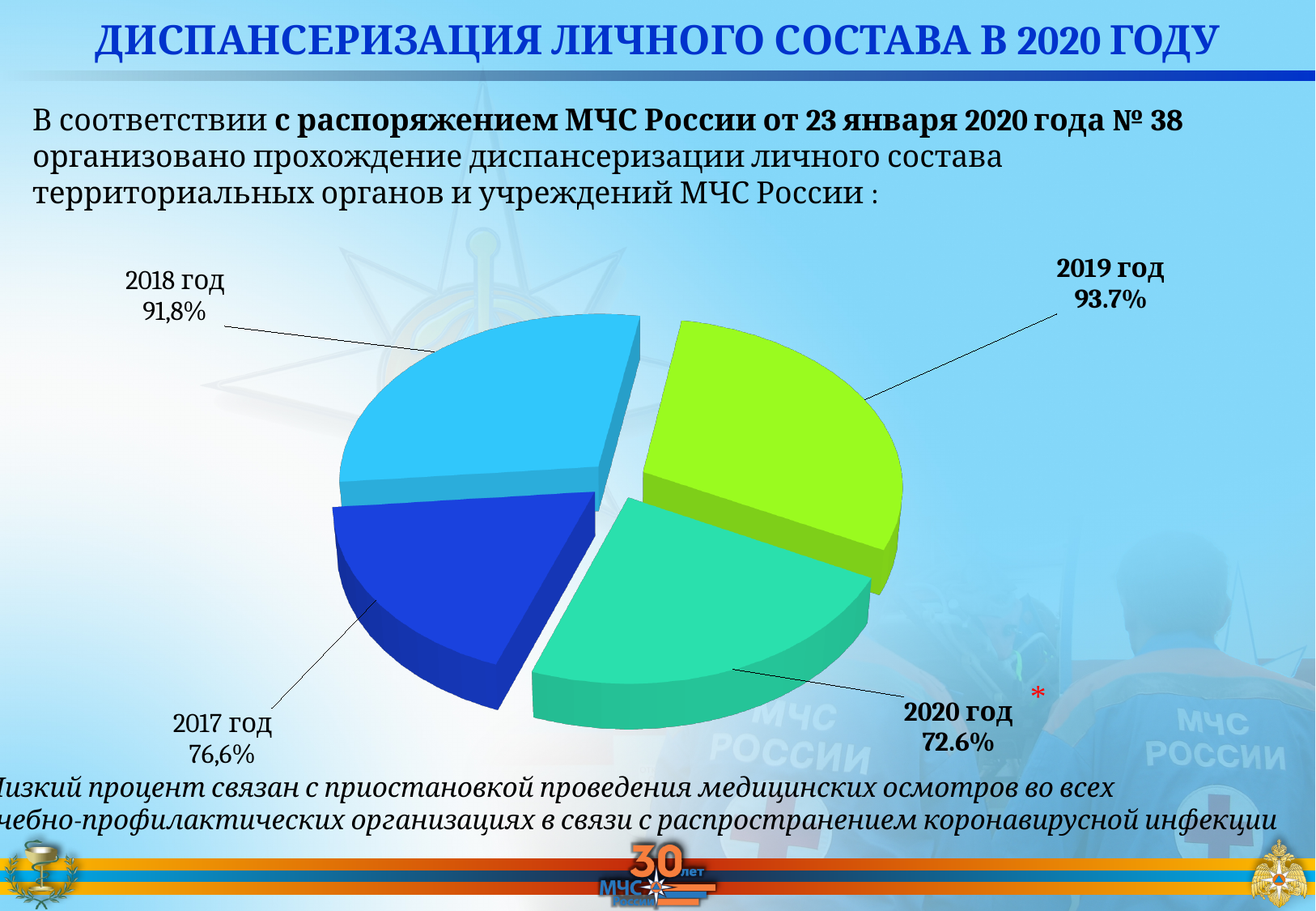
Which year is represented by the dark blue slice? 2017 год What is the difference between the values for 2019 год and 2020 год? 21.1% What is the value shown for 2018 год? 91,8% Which is larger, the value for 2018 год or for 2019 год? 2019 год What is the value shown for 2017 год? 76,6% What kind of chart is shown on the slide? pie chart How many slices does the pie chart have? 4 What is the value shown for 2019 год? 93.7% What is the value shown for 2020 год? 72.6% Did the value rise or fall from 2019 год to 2020 год? fall Which year has the highest value in the pie chart? 2019 год